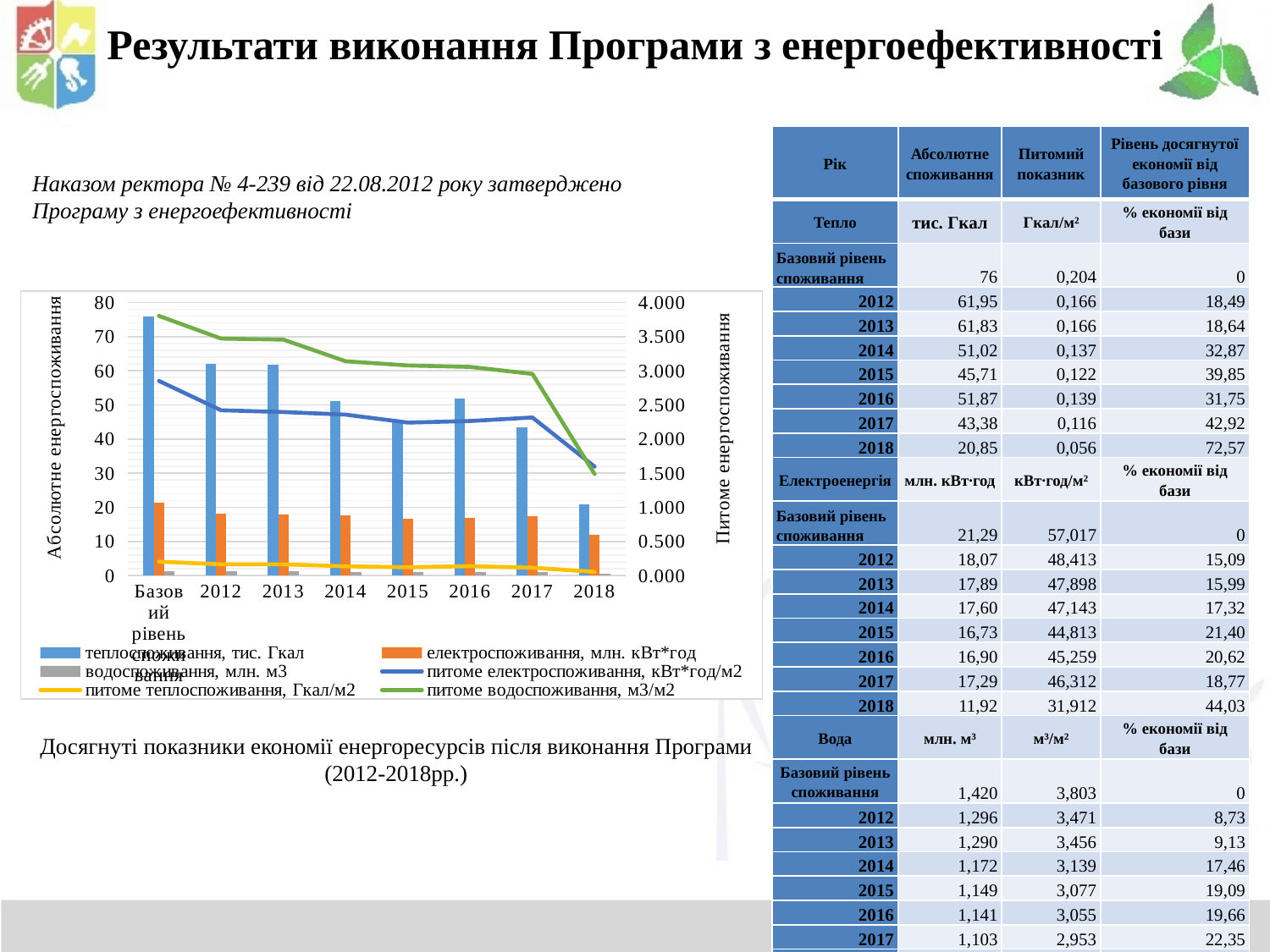
What is the title of the right-hand (secondary) vertical axis of the chart? Питоме енергоспоживання Is the value for теплоспоживання, тис. Гкал at Базовий рівень споживання greater or less than 70? greater Does the line for питоме водоспоживання, м3/м2 rise or fall from Базовий рівень споживання to 2018? Falls Which is larger, теплоспоживання, тис. Гкал in 2015 or in 2016? 2016 What kind of chart is shown on the slide? Combined bar and line chart Is the value for електроспоживання, млн. кВт*год in 2012 greater or less than 20? less How many series does the chart legend list? 6 Is the value for теплоспоживання, тис. Гкал in 2018 greater or less than 30? less Which year has the lowest bar for теплоспоживання, тис. Гкал? 2018 Which category has the highest bar for теплоспоживання, тис. Гкал? Базовий рівень споживання How many categories are shown along the x axis of the chart? 8